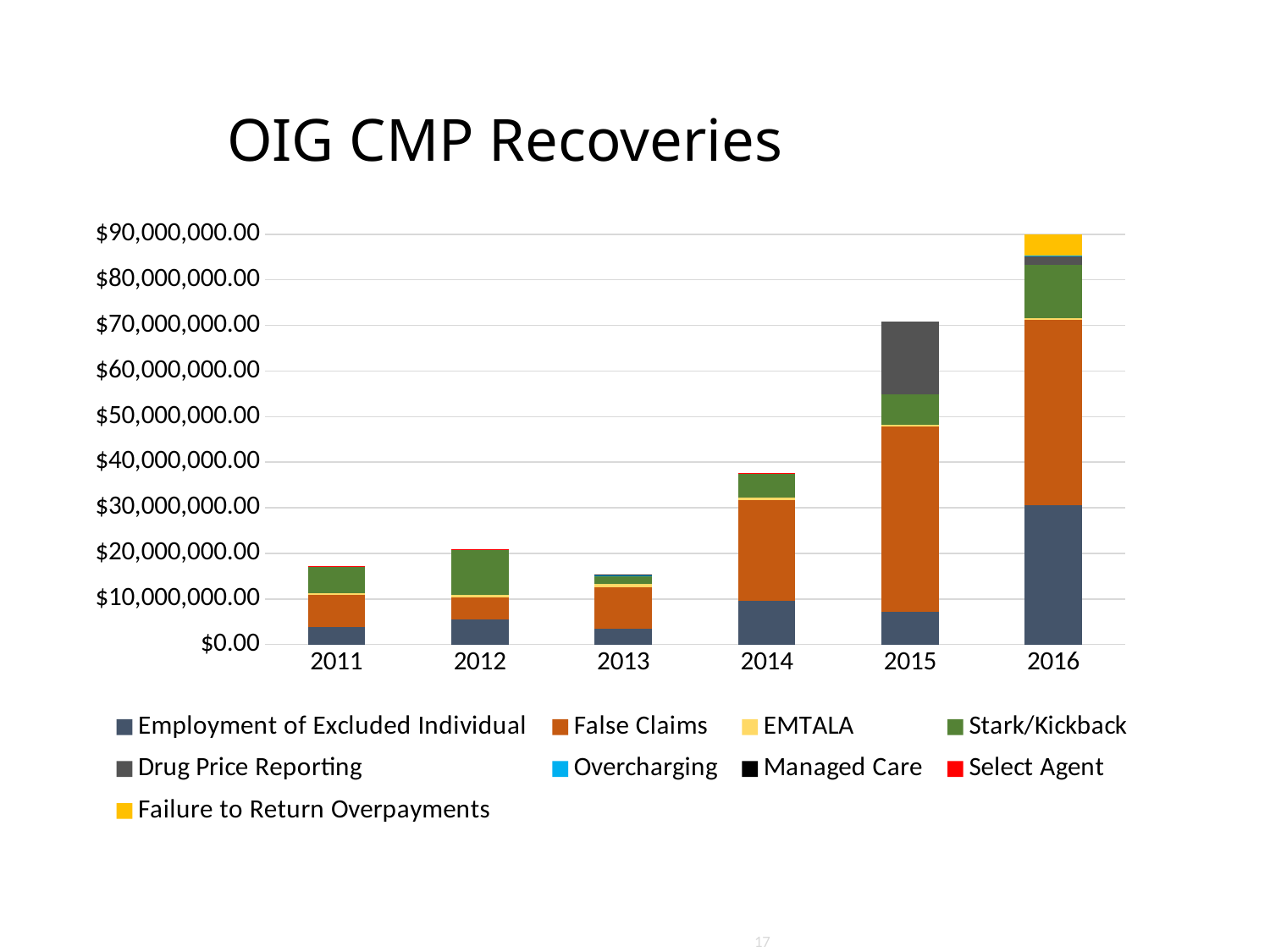
Is the total for 2015 greater or less than $60,000,000.00? greater Is the total for 2014 greater or less than $40,000,000.00? less Do the total recoveries rise or fall from 2013 to 2016? rise What is the title of the chart? OIG CMP Recoveries How many series does the legend list? 9 How many years are shown on the x axis? 6 What kind of chart is shown on the slide? bar chart Which year has the larger total, 2014 or 2015? 2015 Which series is shown in red in the legend? Select Agent Is the total for 2013 greater or less than $20,000,000.00? less Which year has the highest total recoveries? 2016